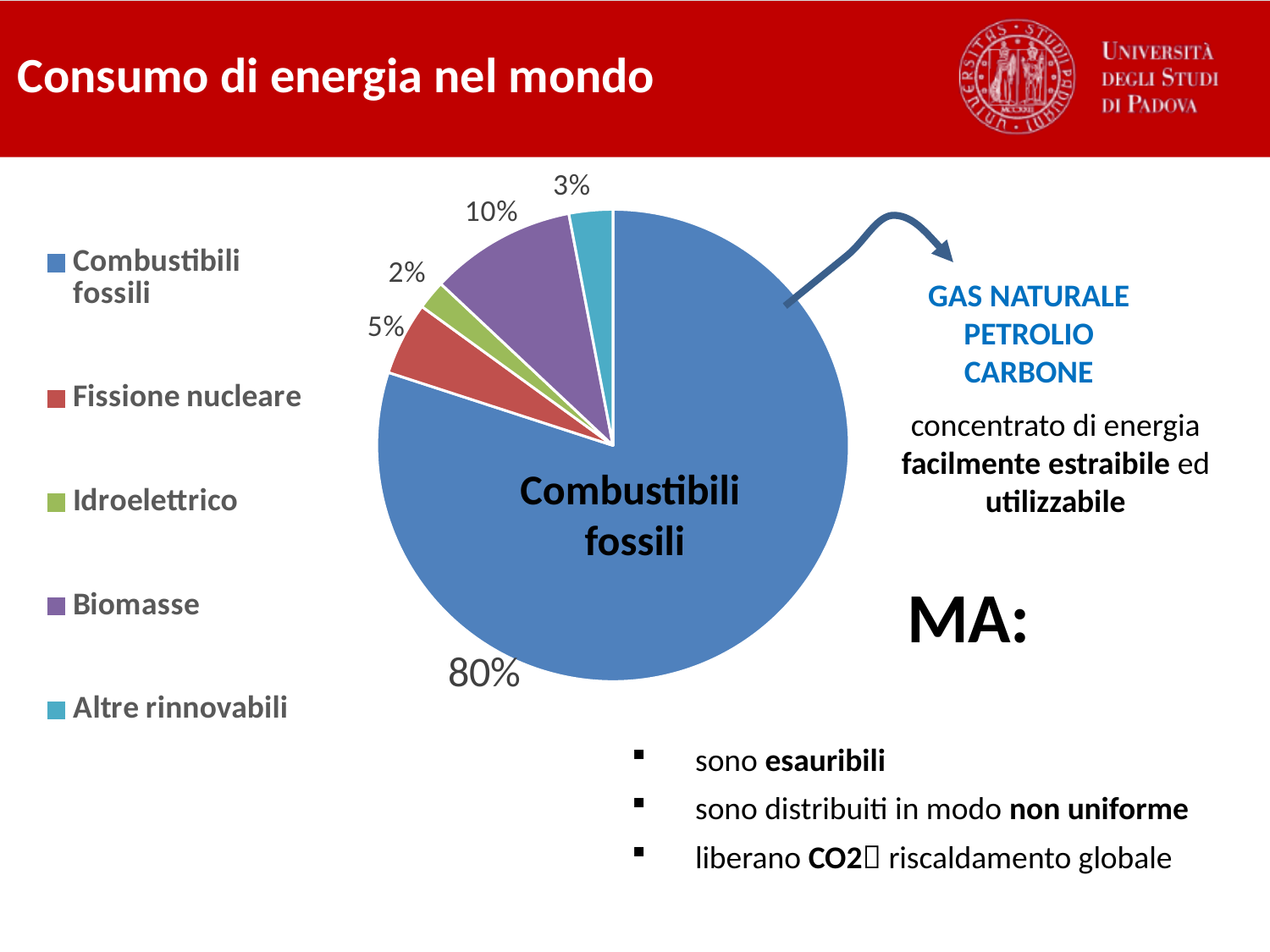
Which colour represents Biomasse in the pie chart? purple What kind of chart is shown on the slide? pie chart What share of the pie does Idroelettrico have? 2% Which category has the largest slice of the pie? Combustibili fossili What share of the pie does Fissione nucleare have? 5% Which is larger, the share of Altre rinnovabili or the share of Idroelettrico? Altre rinnovabili What share of the pie does Biomasse have? 10% How many categories does the pie chart have? 5 What is the difference between the shares of Biomasse and Fissione nucleare? 5% Which category has the smallest slice of the pie? Idroelettrico